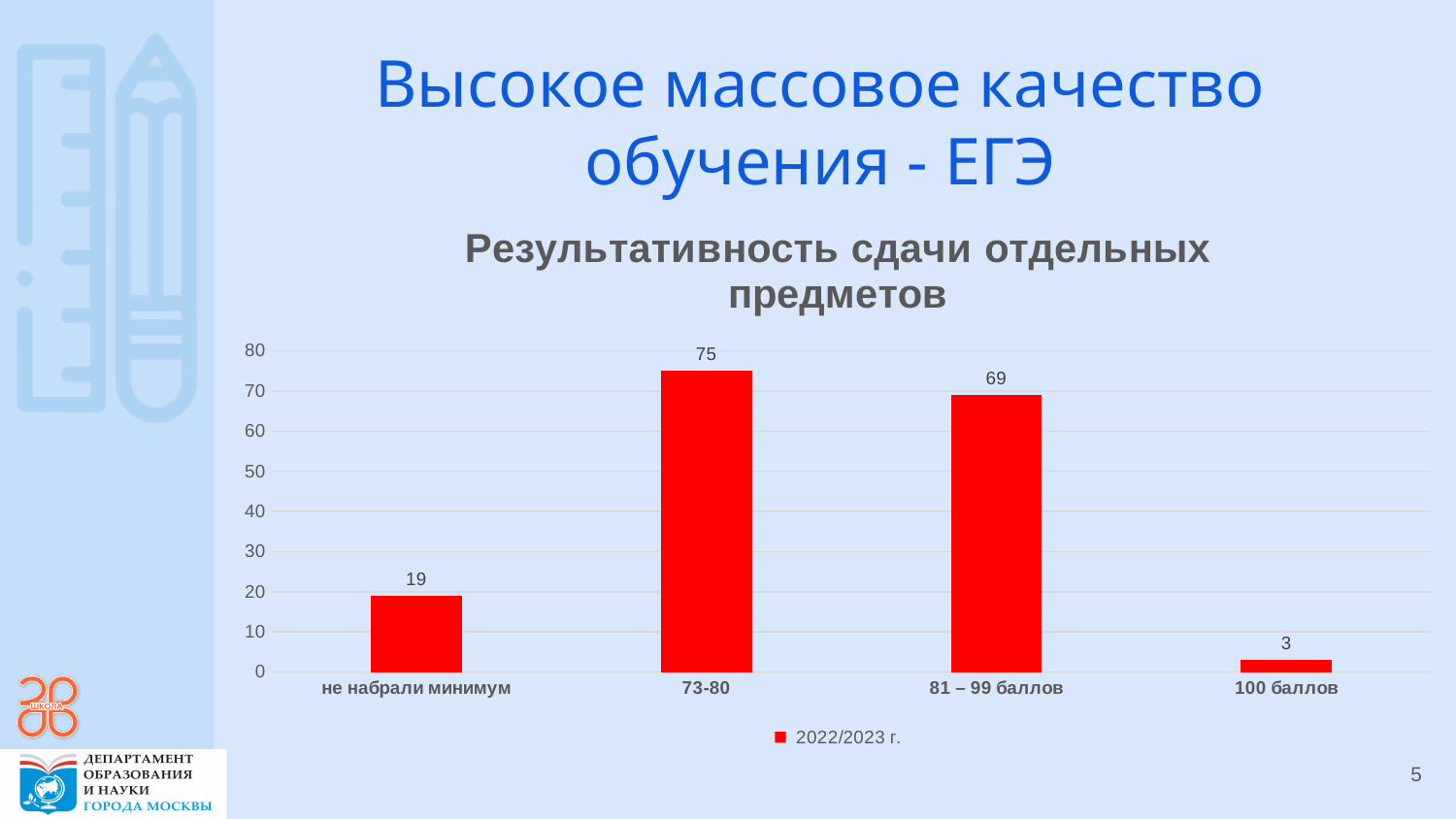
How many categories are shown on the x axis? 4 What is the value for the category "81 – 99 баллов"? 69 What is the value for the category "73-80"? 75 Which category has the highest value? 73-80 How many series does the legend list? 1 Which category has the lowest value? 100 баллов What kind of chart is shown on the slide? bar chart What is the value for the category "не набрали минимум"? 19 What is the difference between the values for "73-80" and "81 – 99 баллов"? 6 What is the value for the category "100 баллов"? 3 Which is larger: the value for "не набрали минимум" or the value for "100 баллов"? не набрали минимум What series name is shown in the legend? 2022/2023 г.